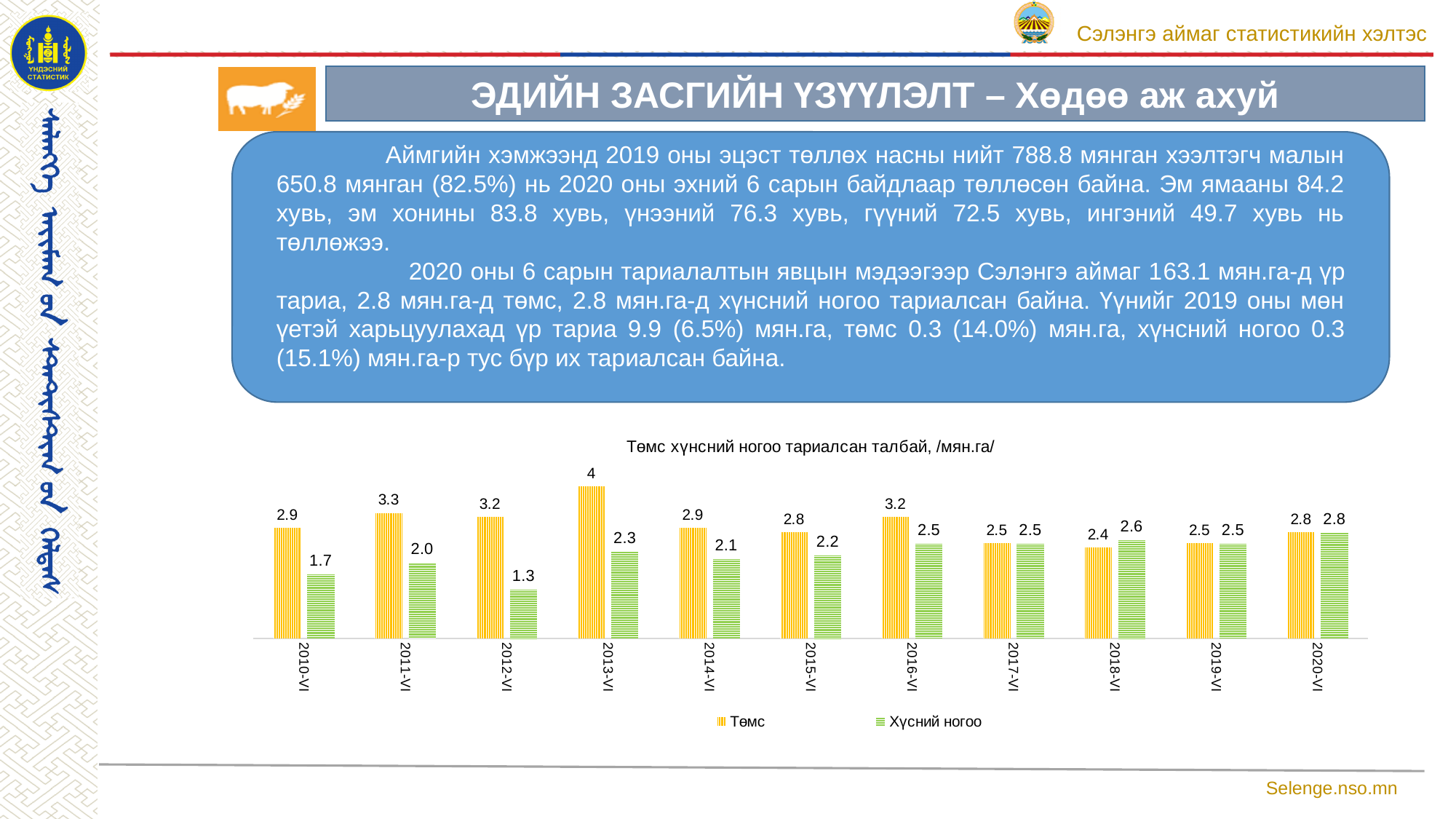
How many years are shown on the x axis? 11 What is the title of the chart? Төмс хүнсний ногоо тариалсан талбай, /мян.га/ In which year is the Төмс value highest? 2013-VI What is the difference between the Төмс and Хүнсний ногоо values in 2013-VI? 1.7 What is the value for Төмс in 2018-VI? 2.4 What kind of chart is shown on the slide? Bar chart What is the value for Хүнсний ногоо in 2012-VI? 1.3 How many series does the legend list? 2 What is the value for Төмс in 2013-VI? 4 Which is larger in 2018-VI, Төмс or Хүнсний ногоо? Хүнсний ногоо In which year is the Хүнсний ногоо value highest? 2020-VI In which year is the Хүнсний ногоо value lowest? 2012-VI